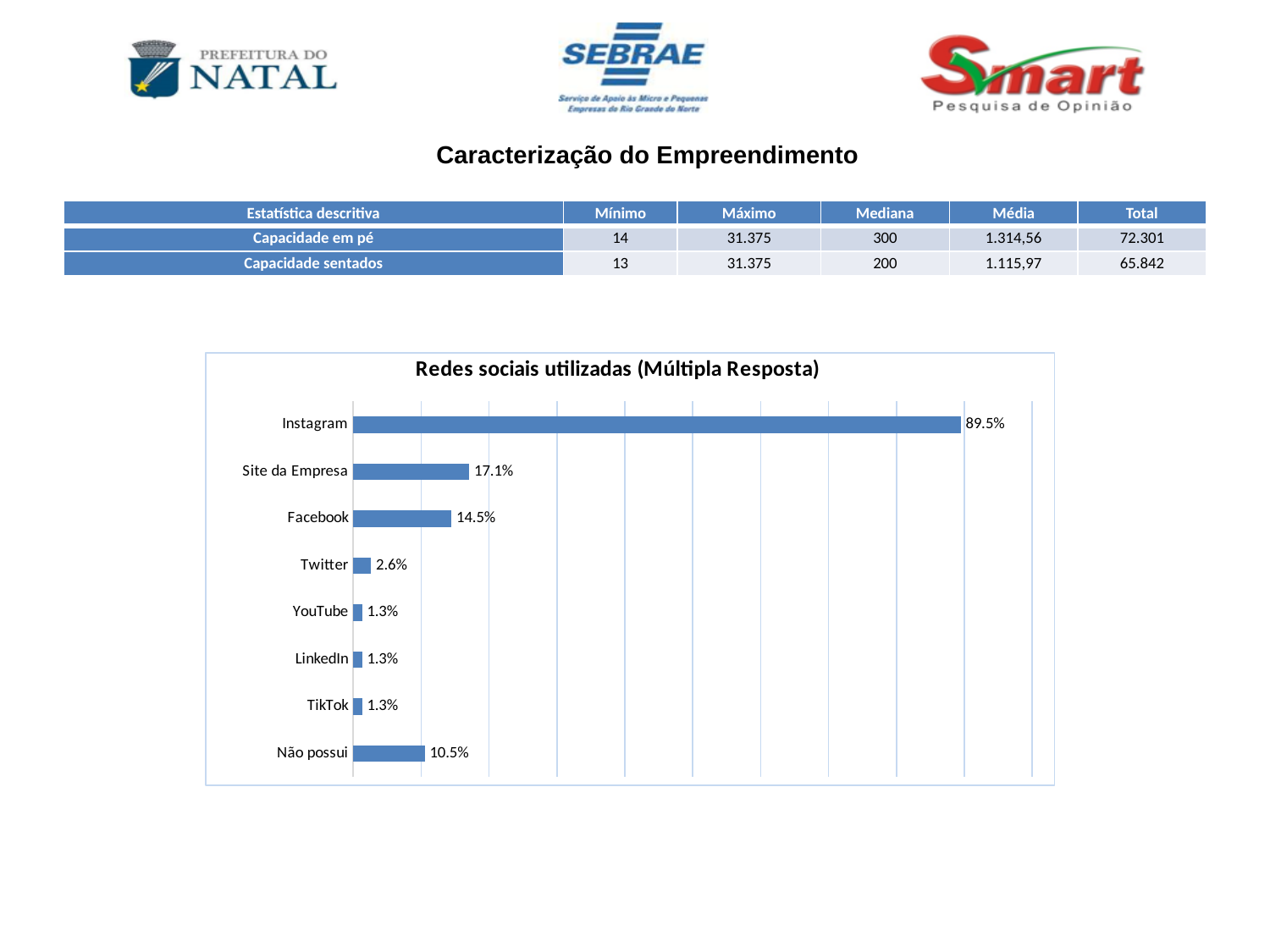
What is the value for Site da Empresa in the chart? 17.1% What is the value for Instagram in the chart? 89.5% What is the value for Não possui in the chart? 10.5% How many categories are shown in the chart? 8 Which category has the highest value in the chart? Instagram Which is larger, the value for Facebook or the value for Não possui? Facebook Which is larger, the value for Twitter or the value for YouTube? Twitter What is the difference between the values for Instagram and Não possui? 79.0% What kind of chart is shown on the slide? Bar chart What is the difference between the values for Site da Empresa and Facebook? 2.6% What is the title of the chart? Redes sociais utilizadas (Múltipla Resposta) What is the value for Twitter in the chart? 2.6%